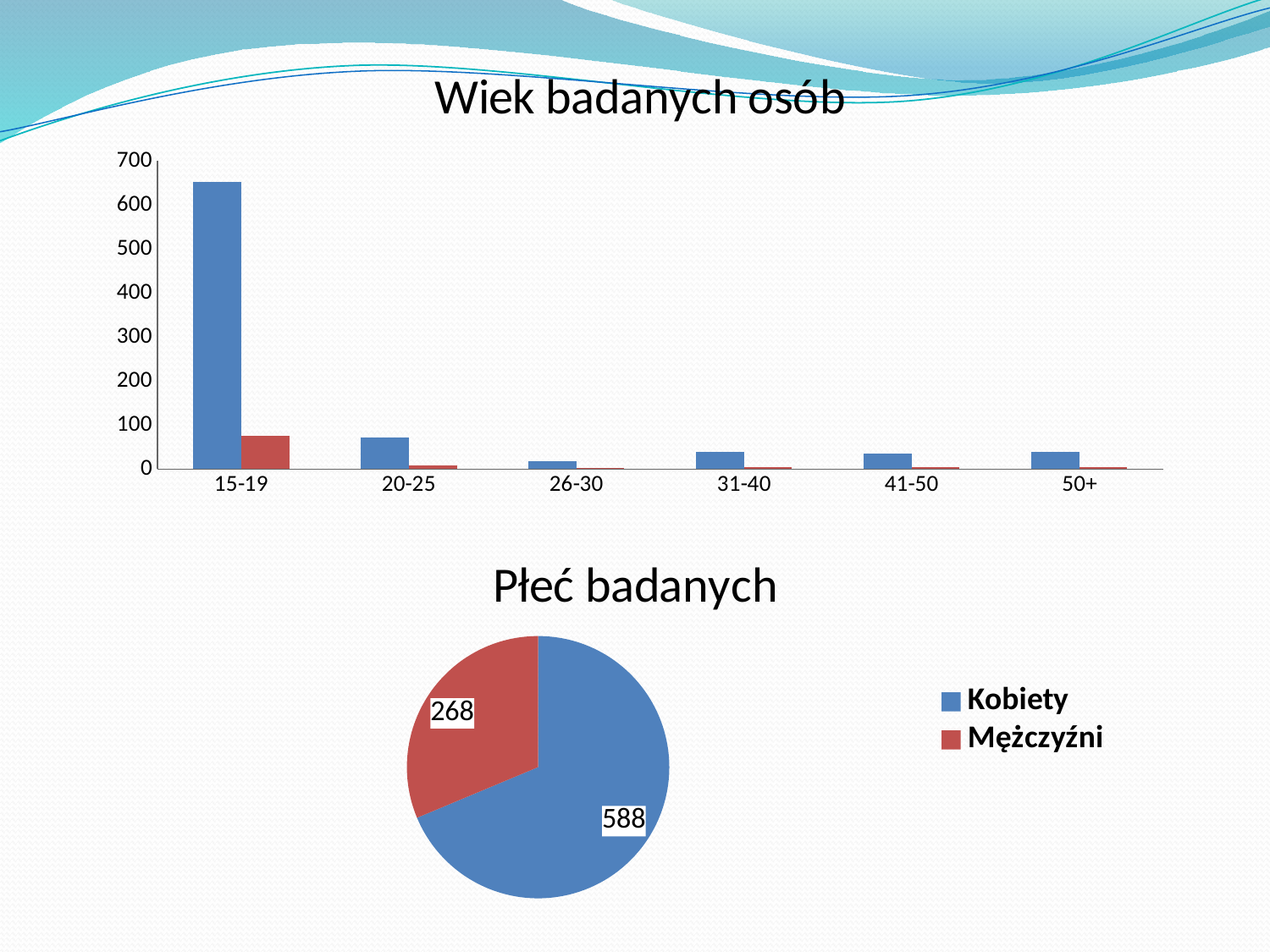
In the chart titled "Wiek badanych osób", which age category has the highest blue bar? 15-19 In the chart titled "Płeć badanych", how many entries does the legend list? 2 In the chart titled "Płeć badanych", what is the total of the two slices? 856 In the chart titled "Płeć badanych", what value is shown for Mężczyźni? 268 In the chart titled "Wiek badanych osób", is the blue bar for 20-25 greater or less than 100? less In the chart titled "Płeć badanych", what is the difference between the Kobiety and Mężczyźni values? 320 In the chart titled "Płeć badanych", what value is shown for Kobiety? 588 What kind of chart is the chart titled "Wiek badanych osób"? bar chart In the chart titled "Wiek badanych osób", how many age categories are shown on the x axis? 6 What kind of chart is the chart titled "Płeć badanych"? pie chart In the chart titled "Wiek badanych osób", is the blue bar for 15-19 greater or less than 600? greater In the chart titled "Płeć badanych", which group is larger, Kobiety or Mężczyźni? Kobiety